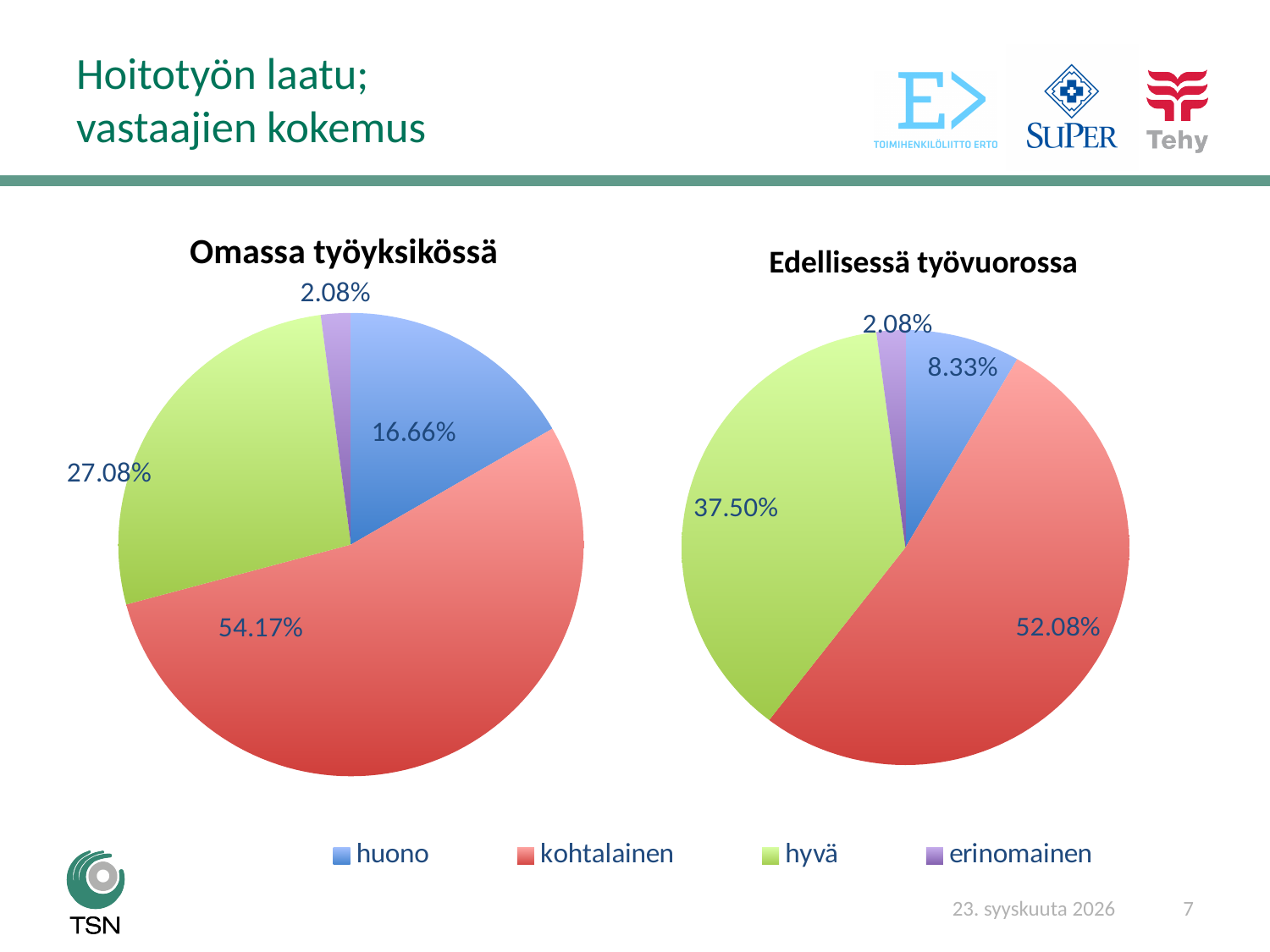
Which colour represents hyvä in the legend? Green In the 'Edellisessä työvuorossa' chart, which category has the smallest slice? erinomainen In the 'Omassa työyksikössä' chart, what is the difference between the kohtalainen and hyvä shares? 27.09% Is the huono share larger in the 'Omassa työyksikössä' chart or in the 'Edellisessä työvuorossa' chart? Omassa työyksikössä In the 'Edellisessä työvuorossa' chart, what share is labelled for hyvä? 37.50% In the 'Omassa työyksikössä' chart, what share is labelled for huono? 16.66% In the 'Edellisessä työvuorossa' chart, what share is labelled for huono? 8.33% In the 'Omassa työyksikössä' chart, what share is labelled for kohtalainen? 54.17% What type of chart is used on this slide? Pie chart In the 'Omassa työyksikössä' chart, which category has the largest slice? kohtalainen How many categories does the legend list? 4 What is the title of the chart on the right? Edellisessä työvuorossa